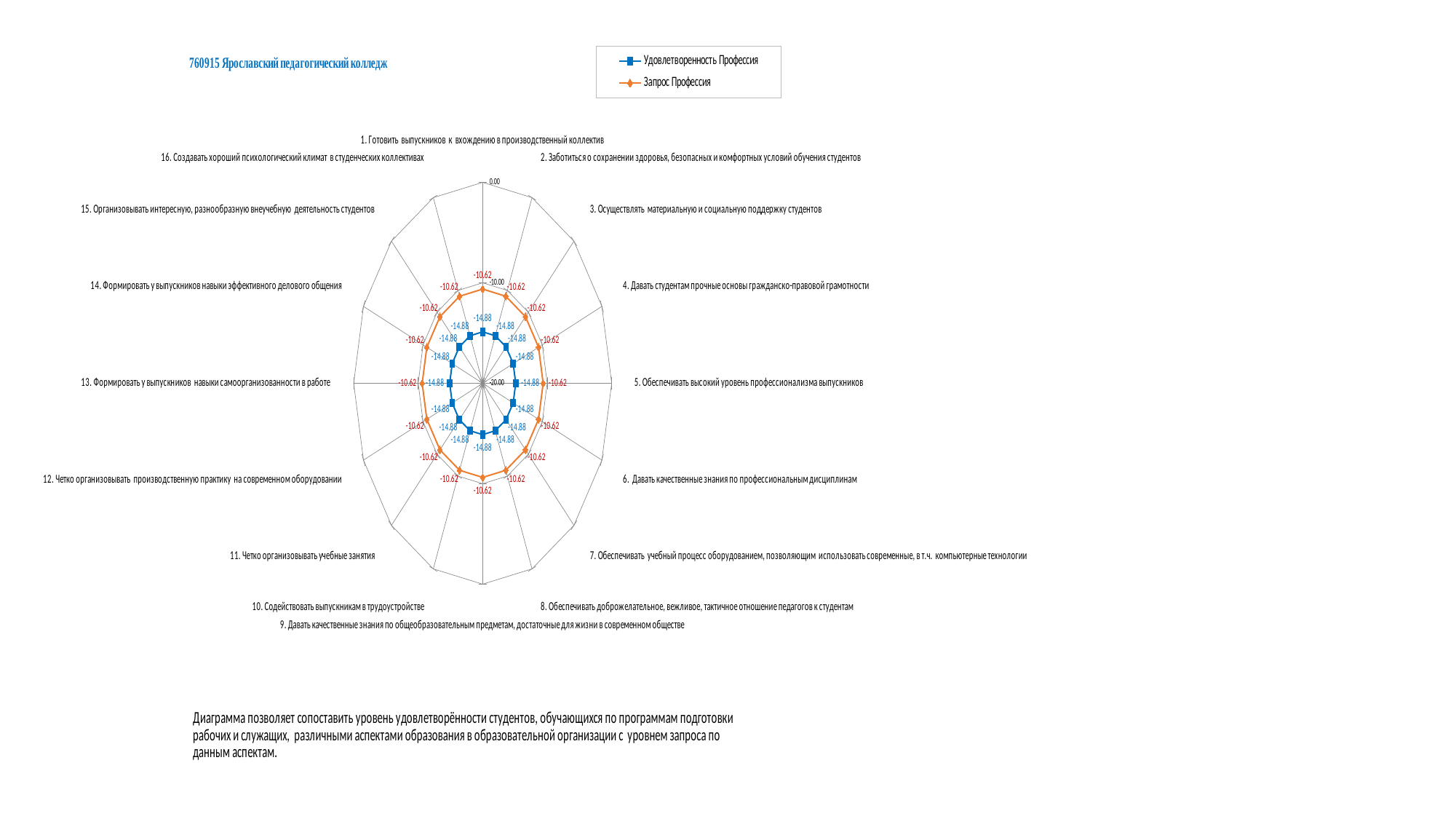
What is the difference between the "Запрос Профессия" value and the "Удовлетворенность Профессия" value for category 7? 4.26 How many categories (axes) does the radar chart have? 16 Is the "Удовлетворенность Профессия" value for category 11 (Четко организовывать учебные занятия) greater or less than -10.00? less What is the value of the "Удовлетворенность Профессия" series for category 13 (Формировать у выпускников навыки самоорганизованности в работе)? -14.88 How many series does the legend list? 2 What kind of chart is shown on the slide? Radar chart What is the value of the "Удовлетворенность Профессия" series for category 5 (Обеспечивать высокий уровень профессионализма выпускников)? -14.88 What is the value of the "Запрос Профессия" series for category 1 (Готовить выпускников к вхождению в производственный коллектив)? -10.62 What is the value of the "Запрос Профессия" series for category 9 (Давать качественные знания по общеобразовательным предметам)? -10.62 Which series has the larger value for category 3 (Осуществлять материальную и социальную поддержку студентов): "Удовлетворенность Профессия" or "Запрос Профессия"? Запрос Профессия What is the title of the chart? 760915 Ярославский педагогический колледж Which series is drawn with orange diamond markers? Запрос Профессия